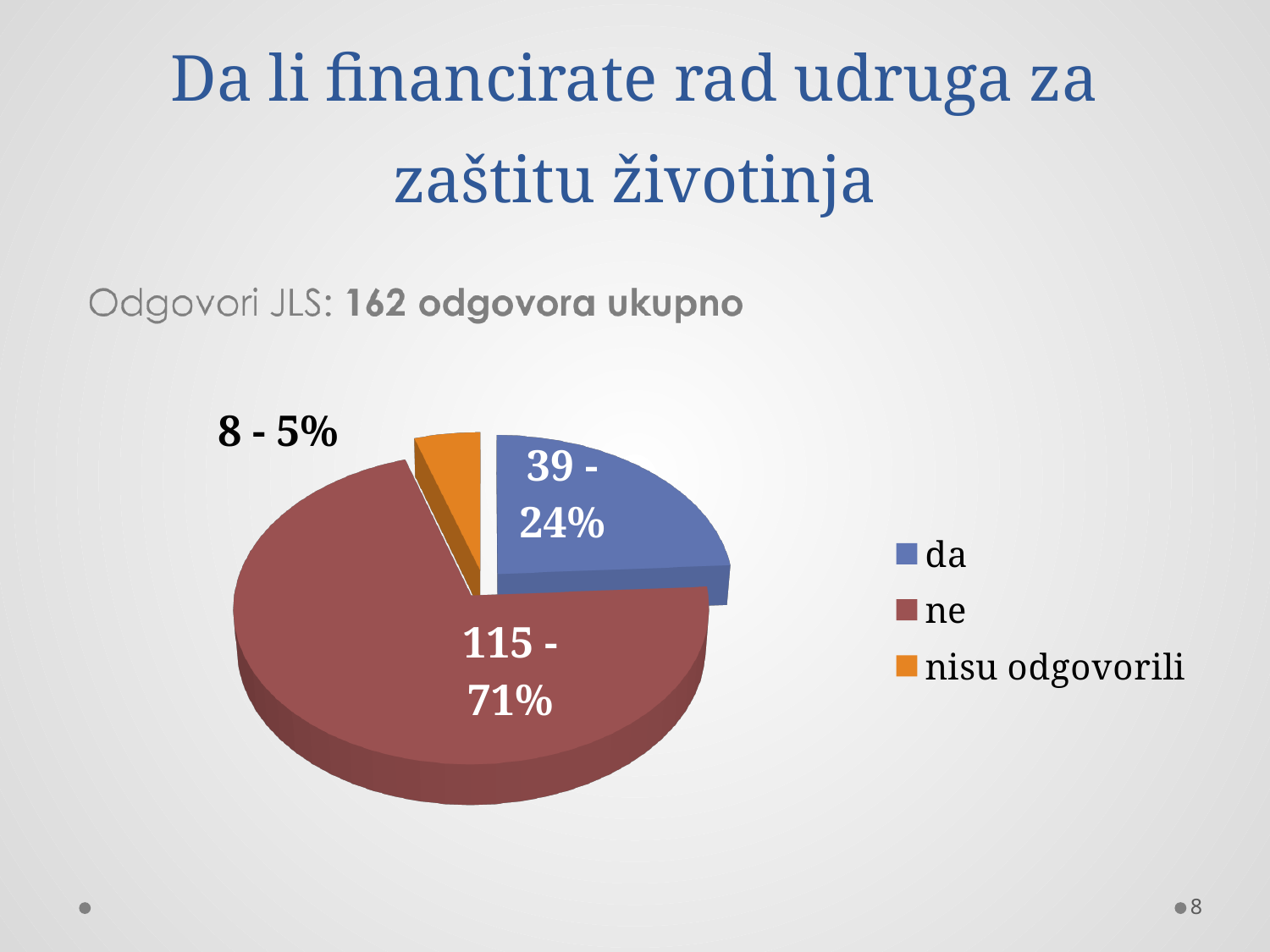
What percentage is shown for the 'da' slice? 24% Which category has the smallest slice? nisu odgovorili Which category has the largest slice? ne Which colour represents the 'da' category in the pie chart? blue How many slices does the pie chart have? 3 What is the count shown for the 'ne' slice? 115 What share of the pie does the 'ne' slice represent? 71% What is the count shown for the 'nisu odgovorili' slice? 8 What share of the pie does the 'nisu odgovorili' slice represent? 5% How many entries does the legend list? 3 What is the difference in count between the 'ne' and 'da' slices? 76 What kind of chart is shown on the slide? pie chart